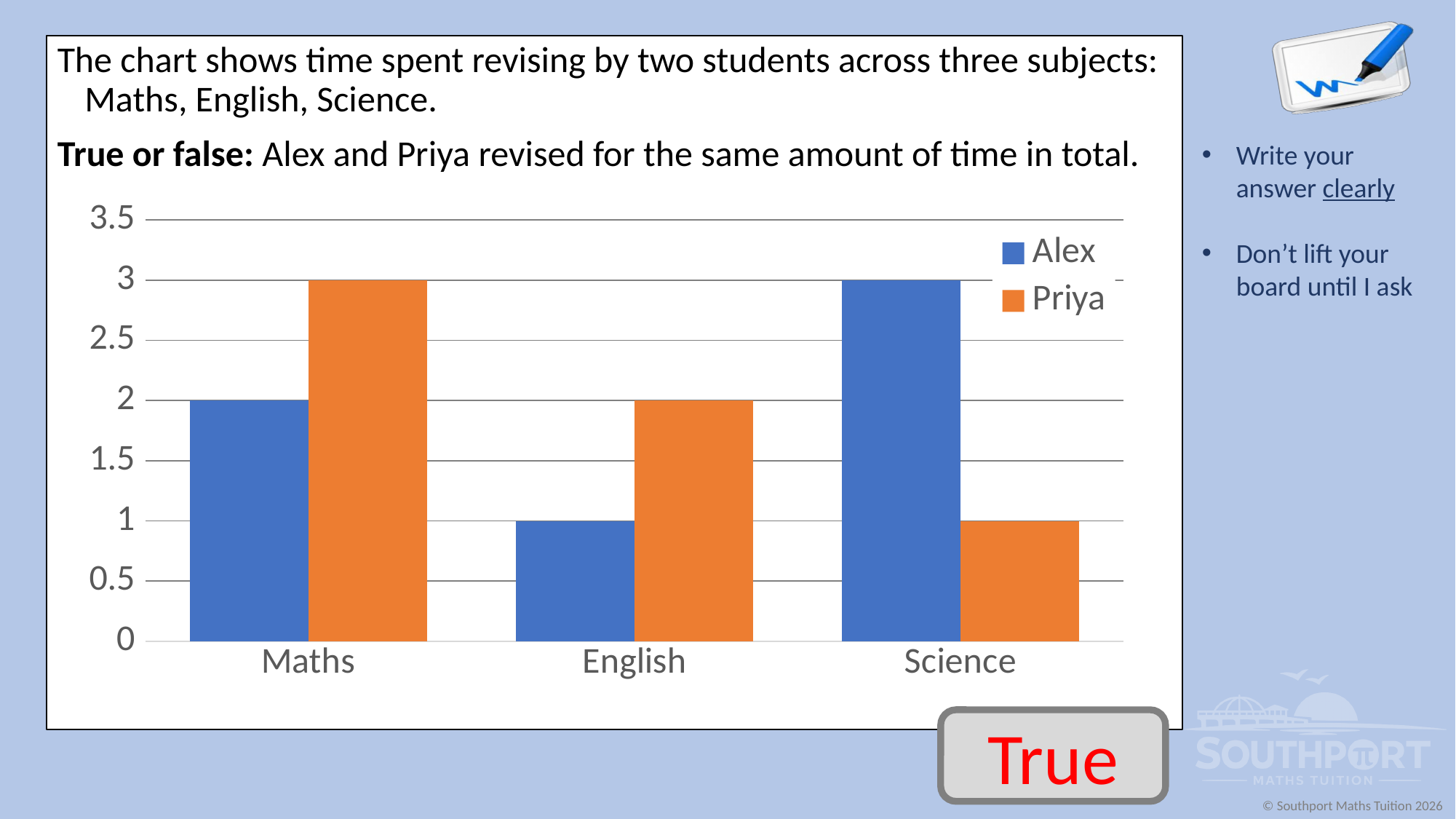
Which colour represents Priya in the legend? orange For which subject is Priya's bar the lowest? Science What value does the Priya bar for Maths reach? 3 What value does the Priya bar for Science reach? 1 What value does the Alex bar for Maths reach? 2 What kind of chart is shown on the slide? bar chart Which is larger for English, Alex's value or Priya's value? Priya What is the difference between Priya's and Alex's values for Maths? 1 How many series does the legend list? 2 What value does the Alex bar for English reach? 1 How many subjects are shown on the x axis? 3 For which subject is Alex's bar the highest? Science